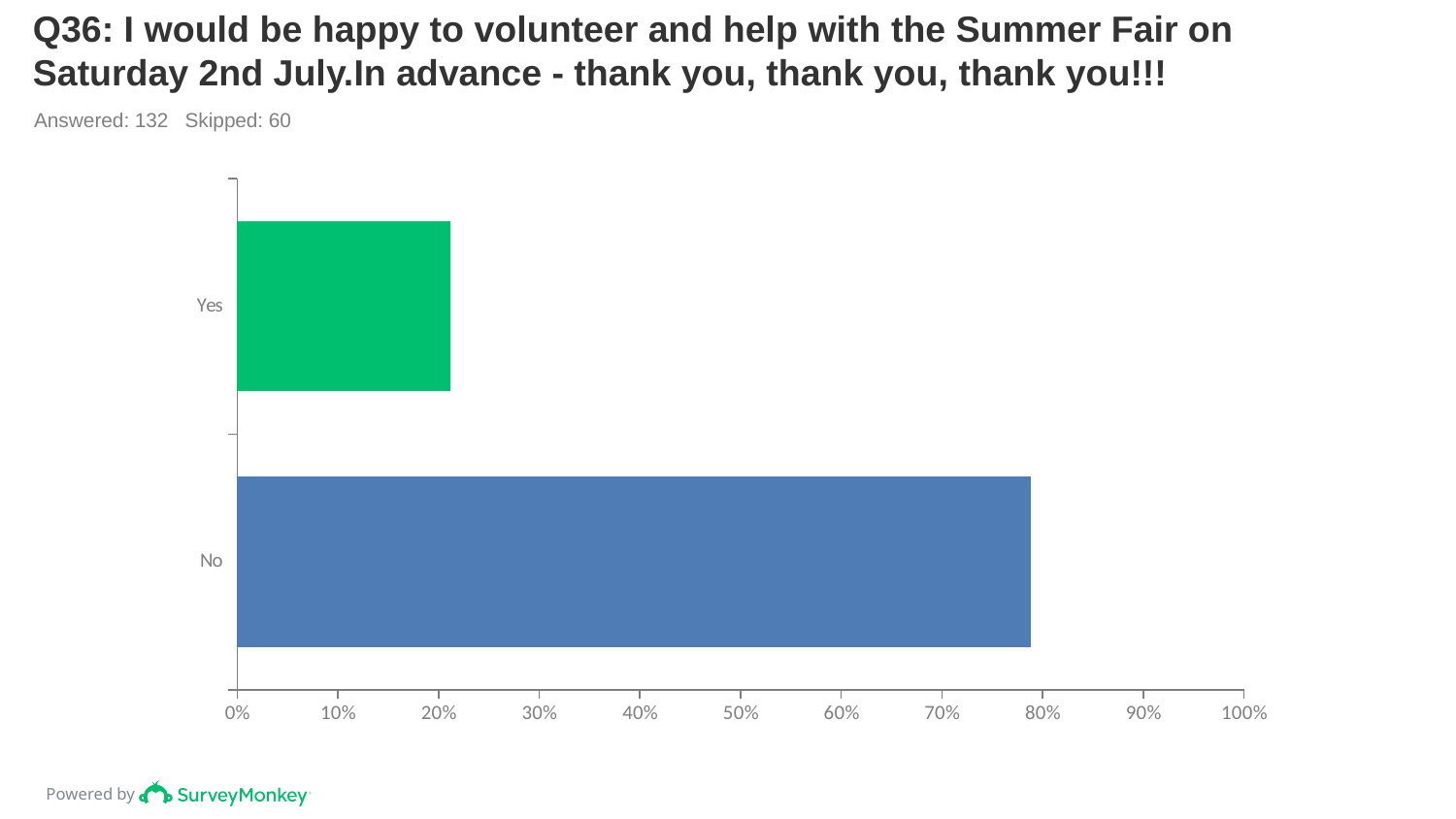
What colour is the bar for Yes? green Is the value for No greater or less than 70%? greater Is the value for Yes greater or less than 10%? greater How many categories are plotted in the chart? 2 What kind of chart is shown on the slide? bar chart How many respondents answered this question, according to the slide? 132 Which is larger, the value for Yes or the value for No? No Which category has the lowest value? Yes Is the value for Yes greater or less than 30%? less Which category has the highest value? No